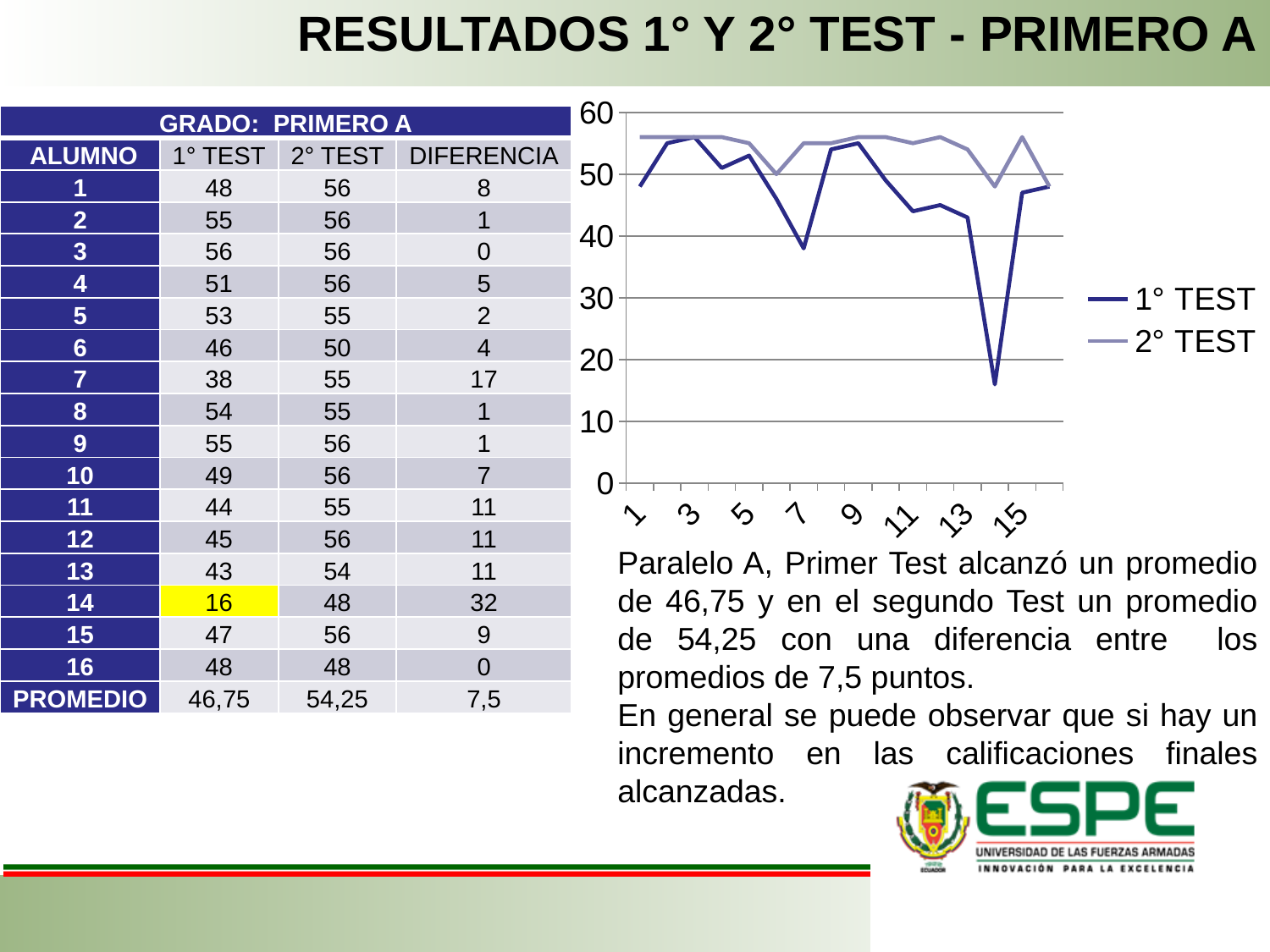
What is the 1° TEST value for student 14? 16 How many students (points) are plotted for each series in the chart? 16 Is the 2° TEST value for student 3 greater or less than 50? greater What kind of chart is shown on the slide? line chart Which student has the lowest 1° TEST value in the chart? 14 What is the 2° TEST value for student 7? 55 How many series does the chart's legend list? 2 For student 7, which series has the larger value, 1° TEST or 2° TEST? 2° TEST Is the 1° TEST value for student 14 greater or less than 20? less Does the 1° TEST line rise or fall from student 13 to student 14? fall What are the two entries in the chart's legend? 1° TEST and 2° TEST What is the difference between the 2° TEST and 1° TEST values for student 7? 17